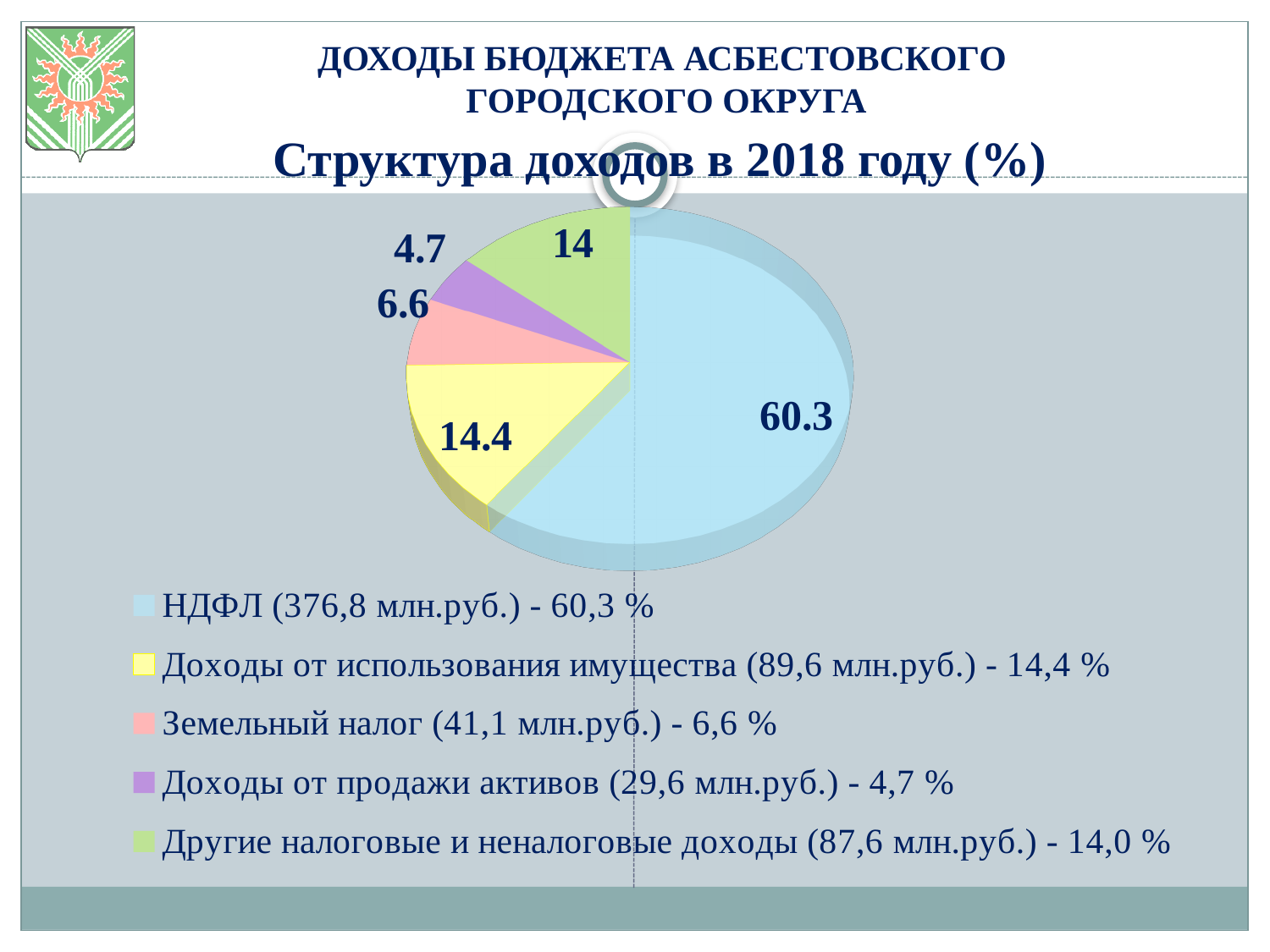
What is the value shown on the pie chart for Доходы от использования имущества? 14.4 Which category has the largest slice of the pie chart? НДФЛ What is the value shown on the pie chart for Земельный налог? 6.6 What is the value shown on the pie chart for Доходы от продажи активов? 4.7 How many slices does the pie chart have? 5 What is the value shown on the pie chart for НДФЛ? 60.3 According to the legend, how many million rubles does Другие налоговые и неналоговые доходы amount to? 87,6 млн.руб. What colour is the slice for НДФЛ in the pie chart? light blue What is the difference between the values for НДФЛ and Доходы от использования имущества? 45.9 Which is larger: the slice for Земельный налог or the slice for Доходы от продажи активов? Земельный налог What kind of chart is shown on the slide? pie chart Which category has the smallest slice of the pie chart? Доходы от продажи активов